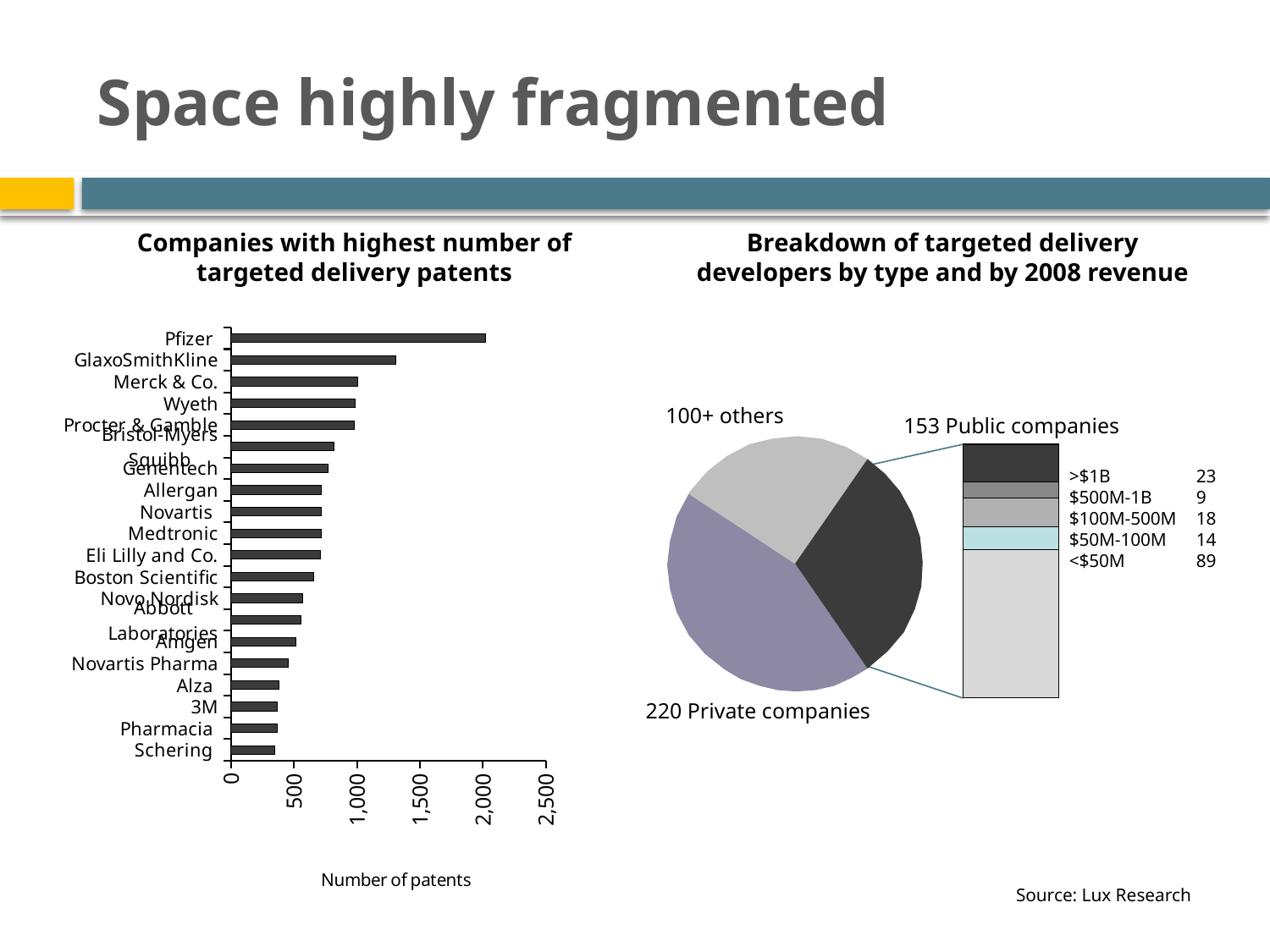
In the 'Companies with highest number of targeted delivery patents' chart, is the value for Pfizer greater or less than 1,500? greater In the 'Breakdown of targeted delivery developers by type and by 2008 revenue' chart, what is the total number of public companies across all revenue bands in the stacked bar? 153 How many companies are shown in the 'Companies with highest number of targeted delivery patents' chart? 20 In the 'Breakdown of targeted delivery developers by type and by 2008 revenue' chart, how many private companies are there? 220 In the 'Companies with highest number of targeted delivery patents' chart, which has more patents, Allergan or 3M? Allergan In the 'Breakdown of targeted delivery developers by type and by 2008 revenue' chart, what is the difference between the number of public companies with >$1B revenue and those with $500M-1B revenue? 14 In the 'Breakdown of targeted delivery developers by type and by 2008 revenue' chart, how many public companies have revenue of >$1B? 23 What is the label on the horizontal axis of the 'Companies with highest number of targeted delivery patents' chart? Number of patents What kind of chart is the 'Companies with highest number of targeted delivery patents' chart? bar chart In the 'Companies with highest number of targeted delivery patents' chart, is the value for Schering greater or less than 500? less In the 'Companies with highest number of targeted delivery patents' chart, is the value for GlaxoSmithKline greater or less than 1,000? greater In the 'Companies with highest number of targeted delivery patents' chart, which company has the highest number of patents? Pfizer